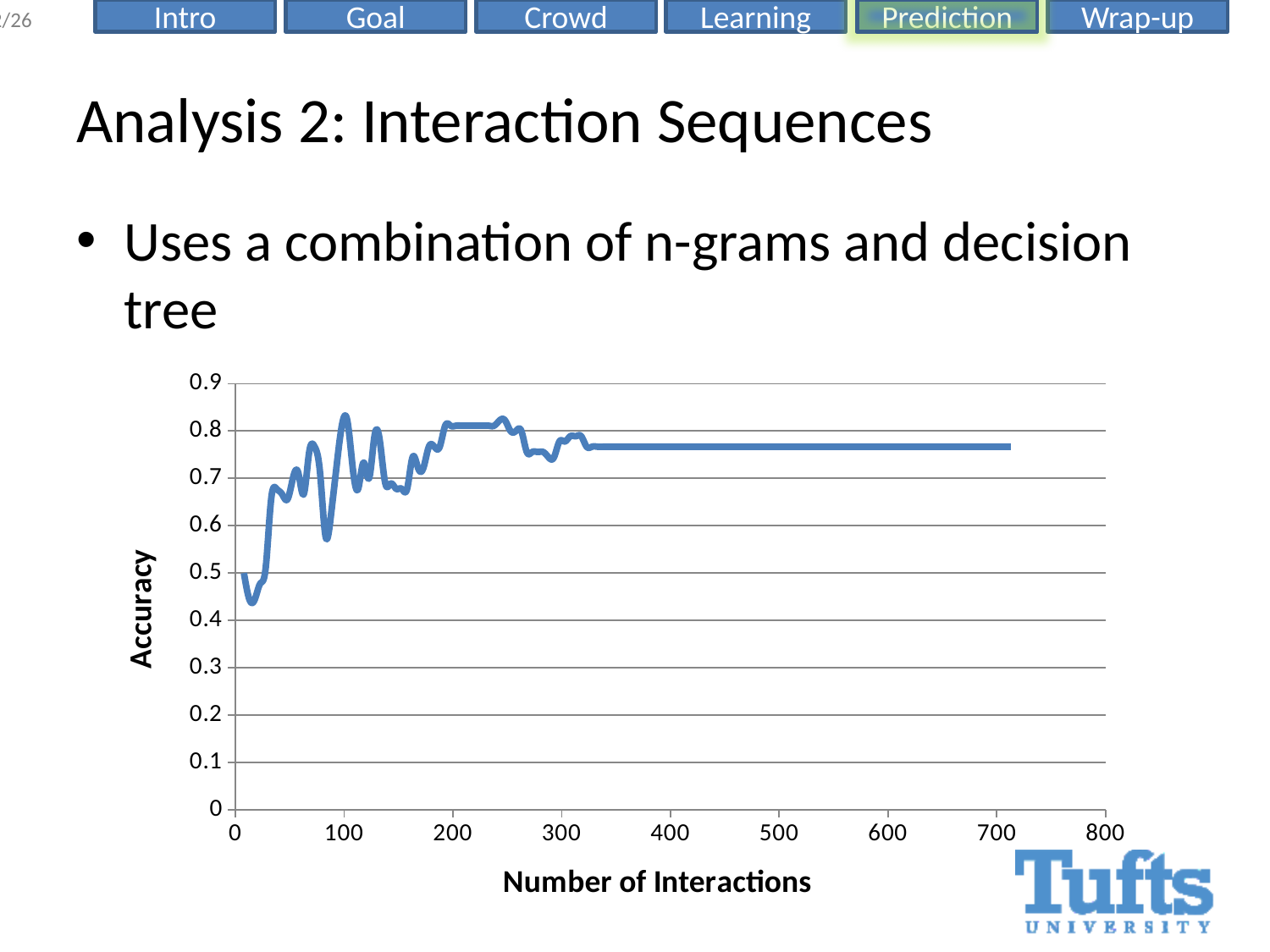
Is the accuracy at 400 interactions greater or less than 0.7? greater Is the accuracy at 500 interactions greater or less than 0.6? greater What kind of chart is shown on the slide? line chart What is the label of the y axis of the chart? Accuracy Is the accuracy at 700 interactions greater or less than 0.7? greater Does accuracy generally rise or fall as the number of interactions increases from 0 to 200? rise Is the accuracy at 200 interactions greater or less than the accuracy at 20 interactions? greater What is the highest value shown on the y axis of the chart? 0.9 What is the label of the x axis of the chart? Number of Interactions